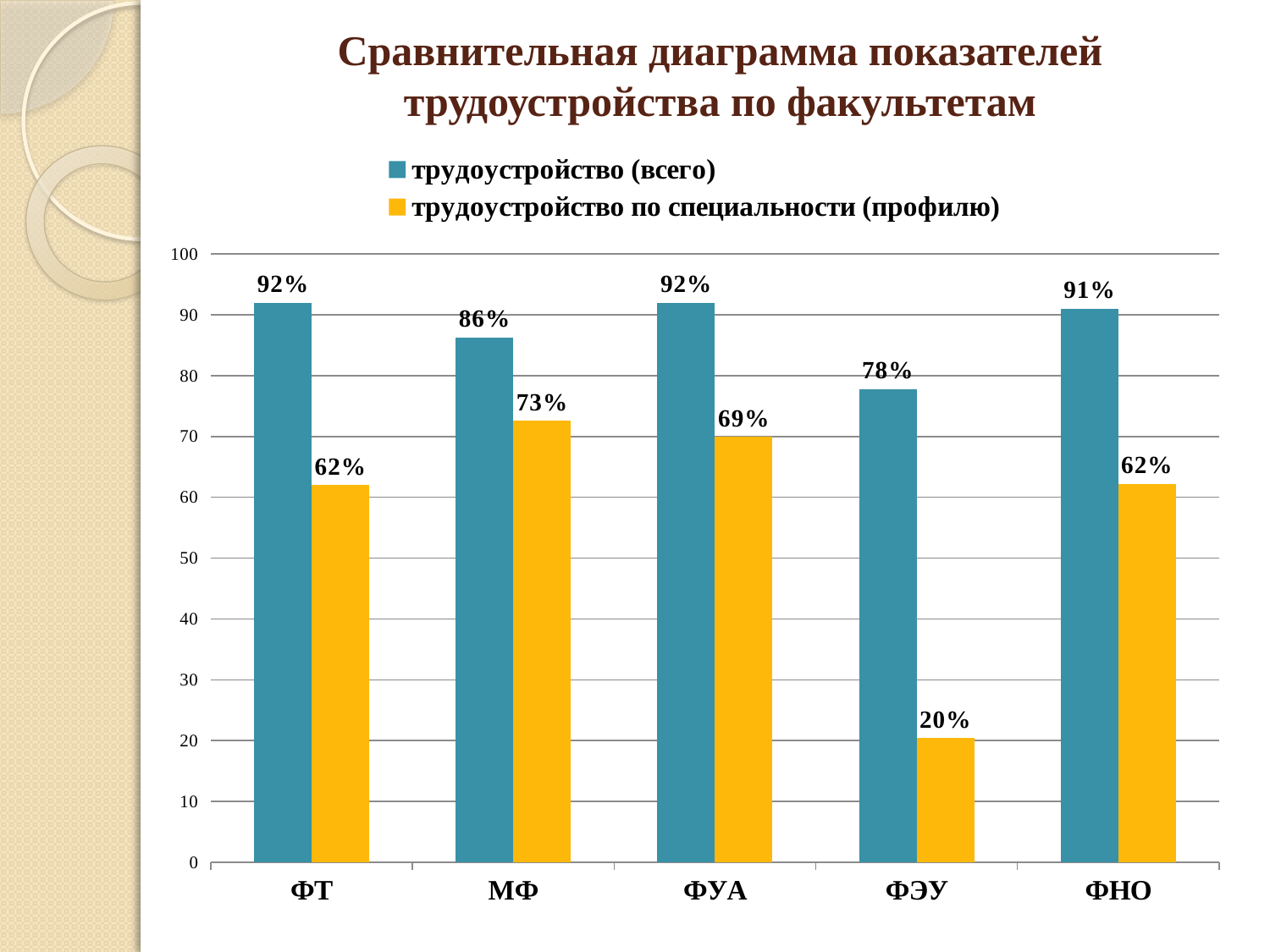
What kind of chart is shown on the slide? Bar chart What is the value of трудоустройство (всего) for ФТ? 92% What colour are the bars for трудоустройство по специальности (профилю)? Yellow Which faculty has the highest value for трудоустройство по специальности (профилю)? МФ What is the difference between трудоустройство (всего) and трудоустройство по специальности (профилю) for ФЭУ? 58% How many faculties are shown on the x axis? 5 What is the value of трудоустройство (всего) for ФНО? 91% What is the value of трудоустройство по специальности (профилю) for МФ? 73% Which is larger: трудоустройство по специальности (профилю) for ФУА or for ФНО? ФУА What is the value of трудоустройство по специальности (профилю) for ФЭУ? 20% How many series does the legend list? 2 Which faculty has the lowest value for трудоустройство (всего)? ФЭУ